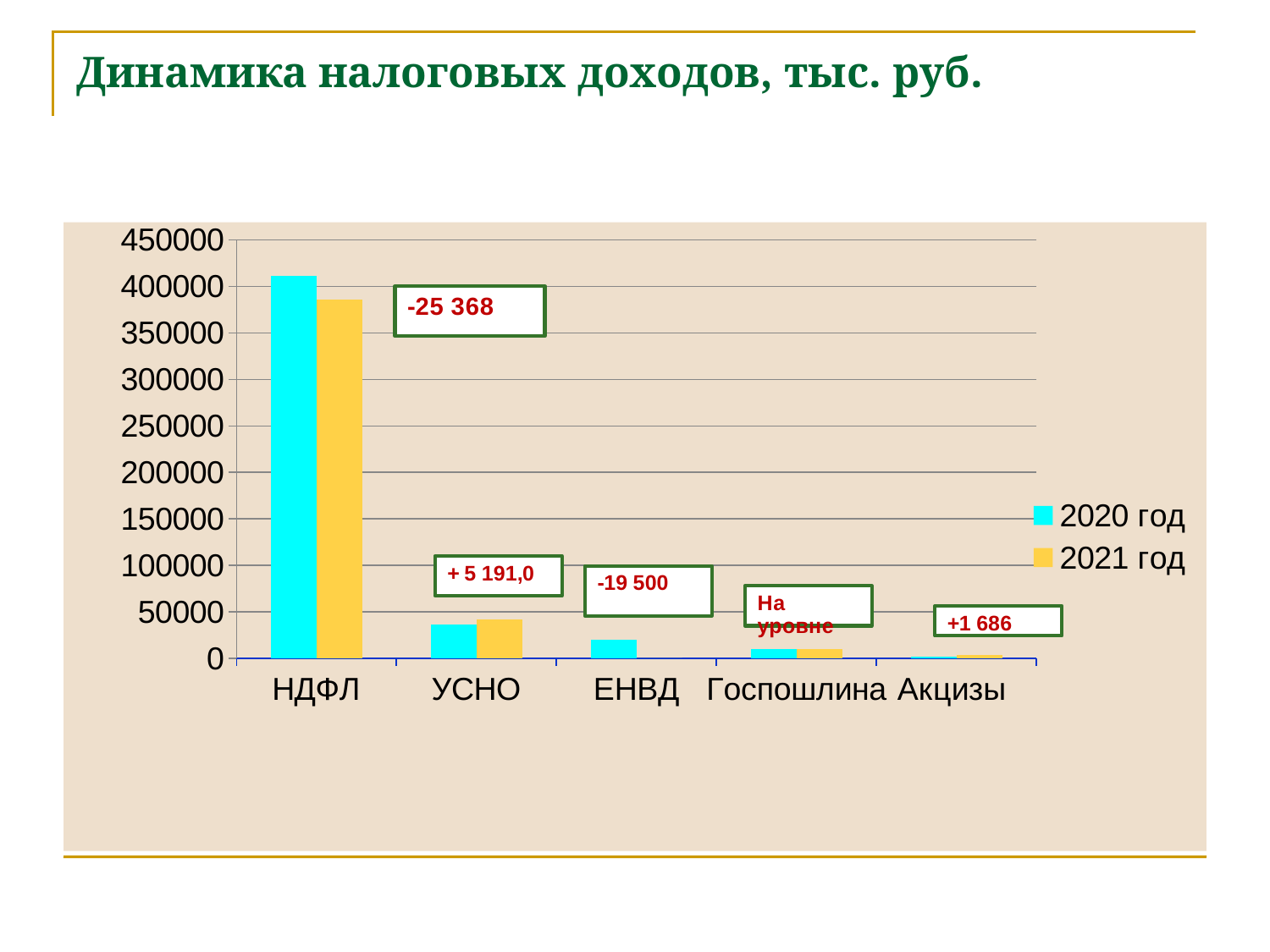
For НДФЛ, which series has the larger value, 2020 год or 2021 год? 2020 год Is the value for НДФЛ in 2020 год greater or less than 350000? greater Do the values for 2020 год rise or fall moving from left to right along the x axis? fall How many categories are shown on the x axis of the chart? 5 Which category has the highest value for 2020 год? НДФЛ For УСНО, which series has the larger value, 2020 год or 2021 год? 2021 год Which category has the lowest value for 2020 год? Акцизы What is the title of the slide containing the chart? Динамика налоговых доходов, тыс. руб. What kind of chart is shown on the slide? bar chart Is the value for НДФЛ in 2021 год greater or less than 400000? less Is the value for УСНО in 2020 год greater or less than 50000? less How many series does the chart legend list? 2